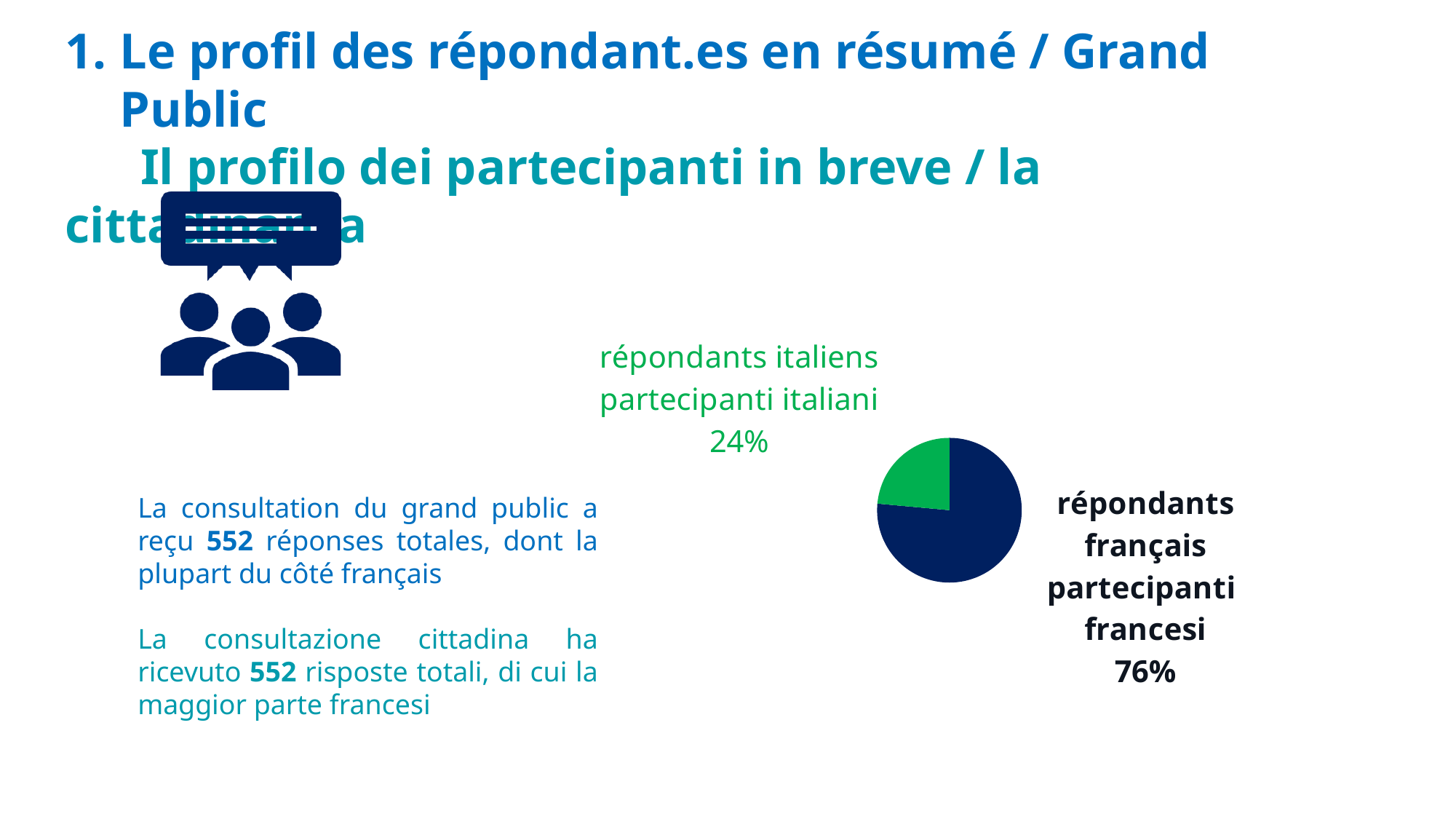
What kind of chart is shown on the slide? pie chart What share of the pie is labelled for Italian respondents (répondants italiens)? 24% Which slice of the pie is the smallest? répondants italiens / partecipanti italiani What share of the pie is labelled for French respondents (répondants français)? 76% Which slice of the pie is the largest? répondants français / partecipanti francesi Do the two slice percentages add up to 100%? yes Which is larger: the share of French respondents or the share of Italian respondents? French respondents How many slices does the pie chart have? 2 What is the difference in percentage points between the French and Italian respondent shares? 52 percentage points What colour is the slice for Italian respondents? green What colour is the slice for French respondents? dark blue